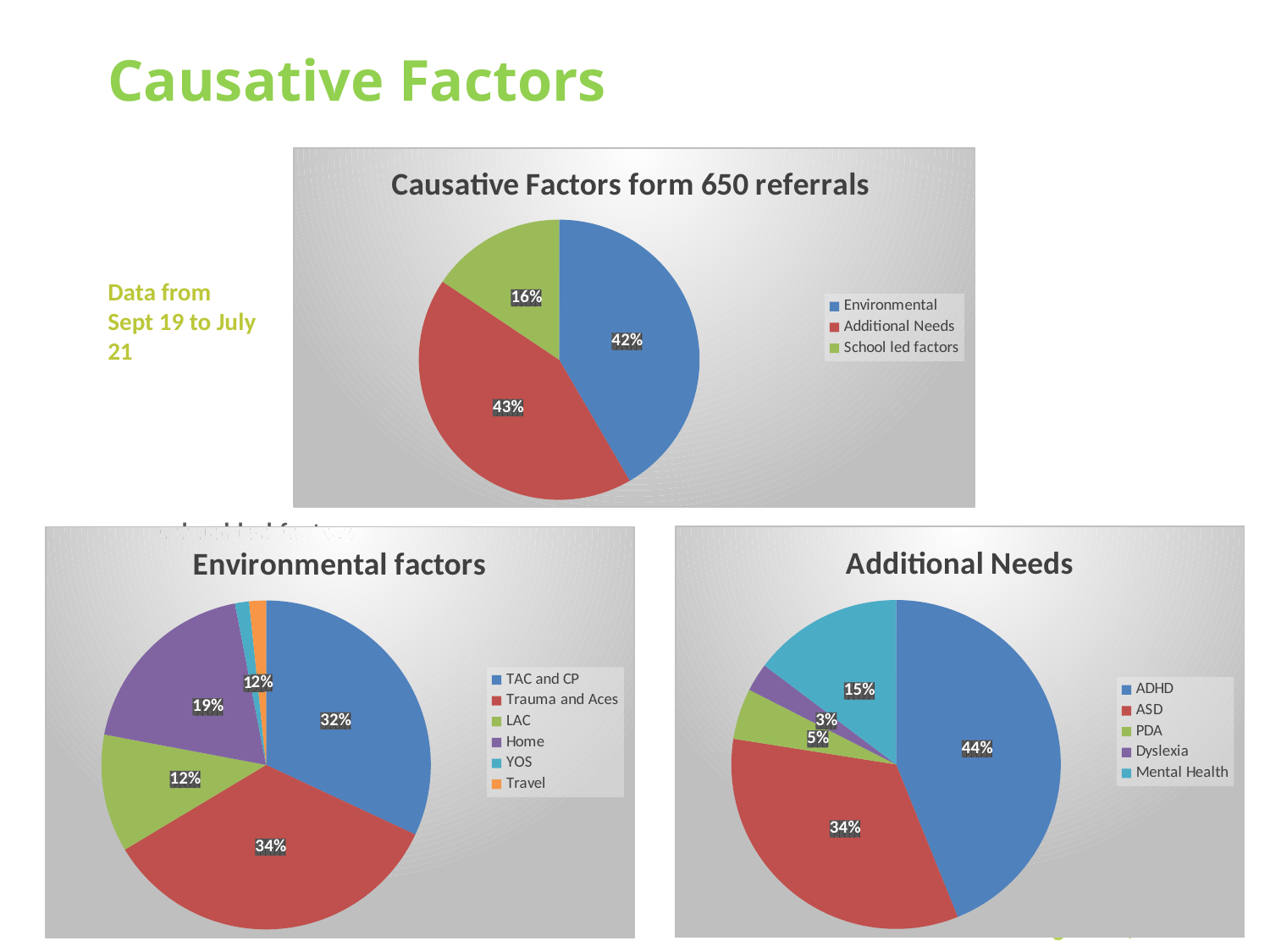
In the 'Causative Factors form 650 referrals' chart, what percentage is Additional Needs? 43% In the 'Additional Needs' chart, which category has the largest share? ADHD In the 'Environmental factors' chart, which category has the largest share? Trauma and Aces How many categories does the legend of the 'Environmental factors' chart list? 6 In the 'Causative Factors form 650 referrals' chart, which category has the smallest share? School led factors What type of chart is the 'Additional Needs' chart? Pie chart In the 'Environmental factors' chart, what percentage is Trauma and Aces? 34% In the 'Environmental factors' chart, what percentage is Home? 19% In the 'Causative Factors form 650 referrals' chart, what percentage is School led factors? 16% In the 'Causative Factors form 650 referrals' chart, what is the difference in percentage points between Additional Needs and Environmental? 1 In the 'Additional Needs' chart, what percentage is Mental Health? 15% In the 'Additional Needs' chart, which is larger, PDA or Dyslexia? PDA